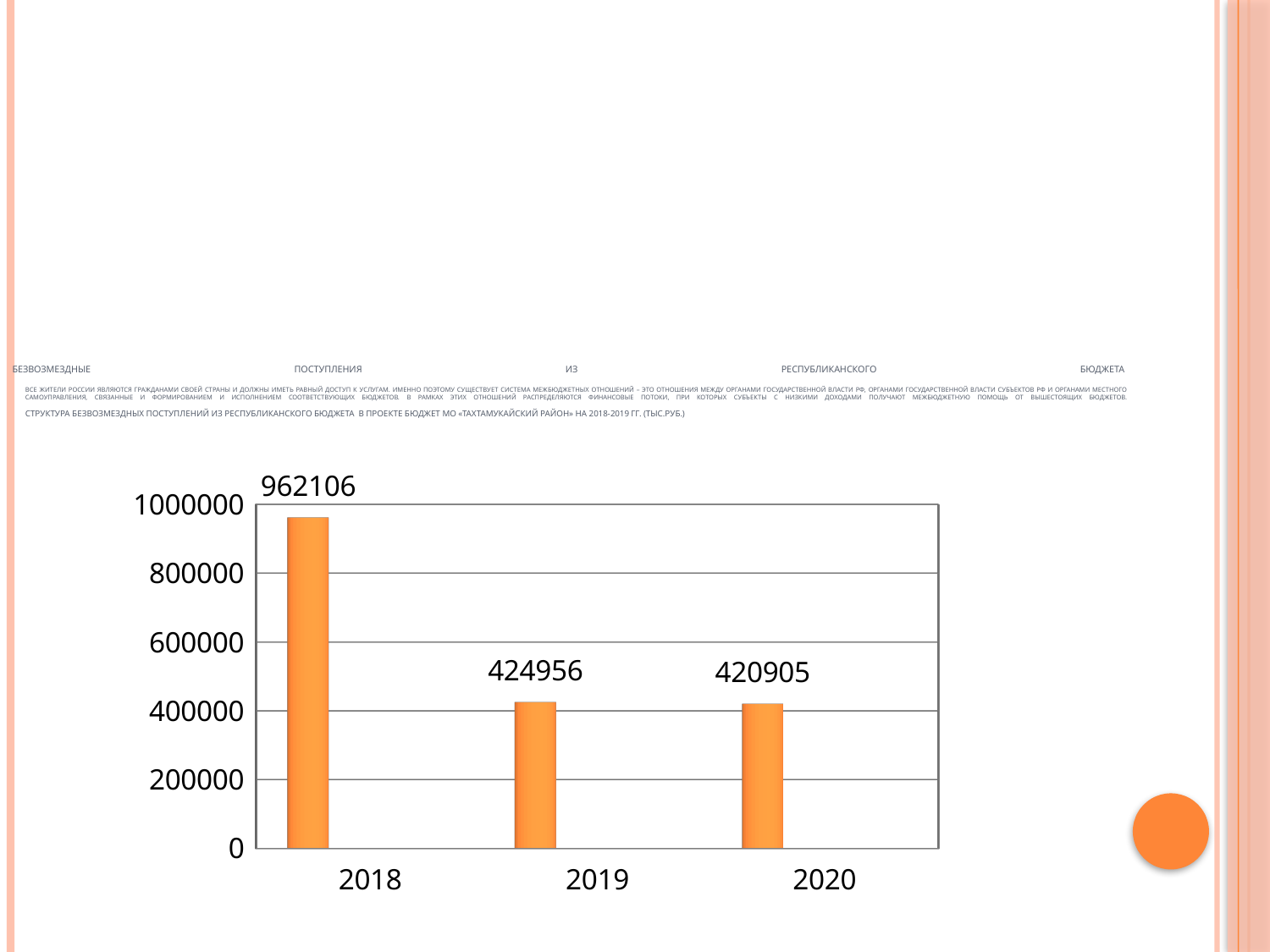
What is the value for 2019? 424956 What is the value for 2018? 962106 Is the value for 2019 greater or less than 600000? less What is the value for 2020? 420905 What is the difference between the values for 2018 and 2019? 537150 Which year has the lowest value? 2020 How many years are shown on the x axis? 3 What is the difference between the values for 2019 and 2020? 4051 Which year has the highest value? 2018 Do the values rise or fall from 2018 to 2020? fall Which is larger, the value for 2018 or the value for 2020? 2018 What kind of chart is shown on the slide? bar chart